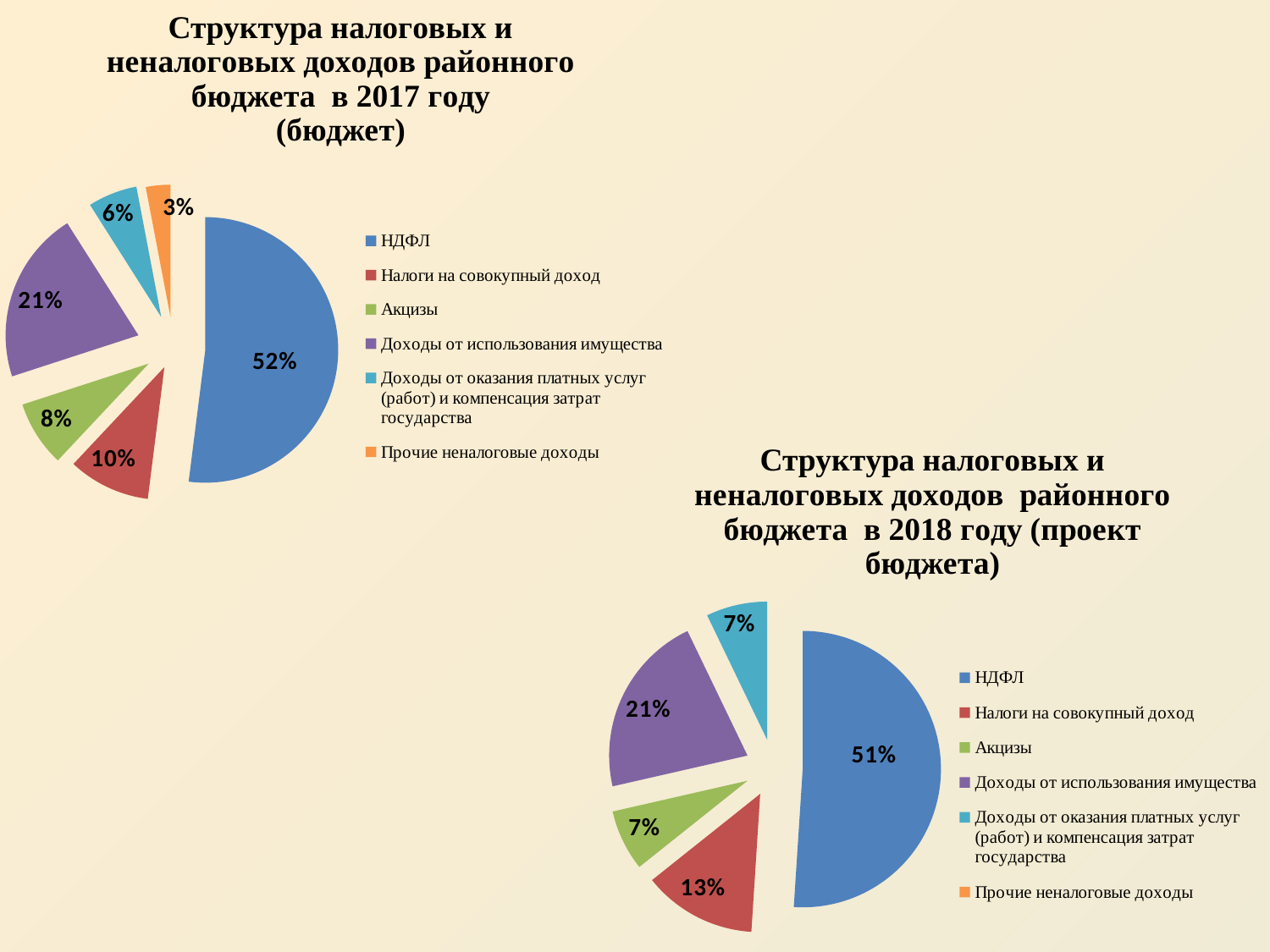
In the 2018 chart, what share do Налоги на совокупный доход have? 13% In the 2017 chart (Структура налоговых и неналоговых доходов районного бюджета в 2017 году), what share does НДФЛ have? 52% In the 2018 chart (Структура налоговых и неналоговых доходов районного бюджета в 2018 году), what share does НДФЛ have? 51% What type of chart is used on the slide for the 2017 budget structure? Pie chart In the 2018 chart, which is larger: the share of Налоги на совокупный доход or the share of Акцизы? Налоги на совокупный доход How many entries does the legend of the 2018 chart list? 6 In the 2017 chart, which category has the smallest share? Прочие неналоговые доходы In the 2017 chart, which category has the largest share? НДФЛ In the 2017 chart, what share do Налоги на совокупный доход have? 10% In the 2017 chart, what is the difference between the shares of Доходы от использования имущества and Акцизы? 13% In the 2018 chart, what share do Доходы от использования имущества have? 21% In the 2017 chart, what share do Прочие неналоговые доходы have? 3%